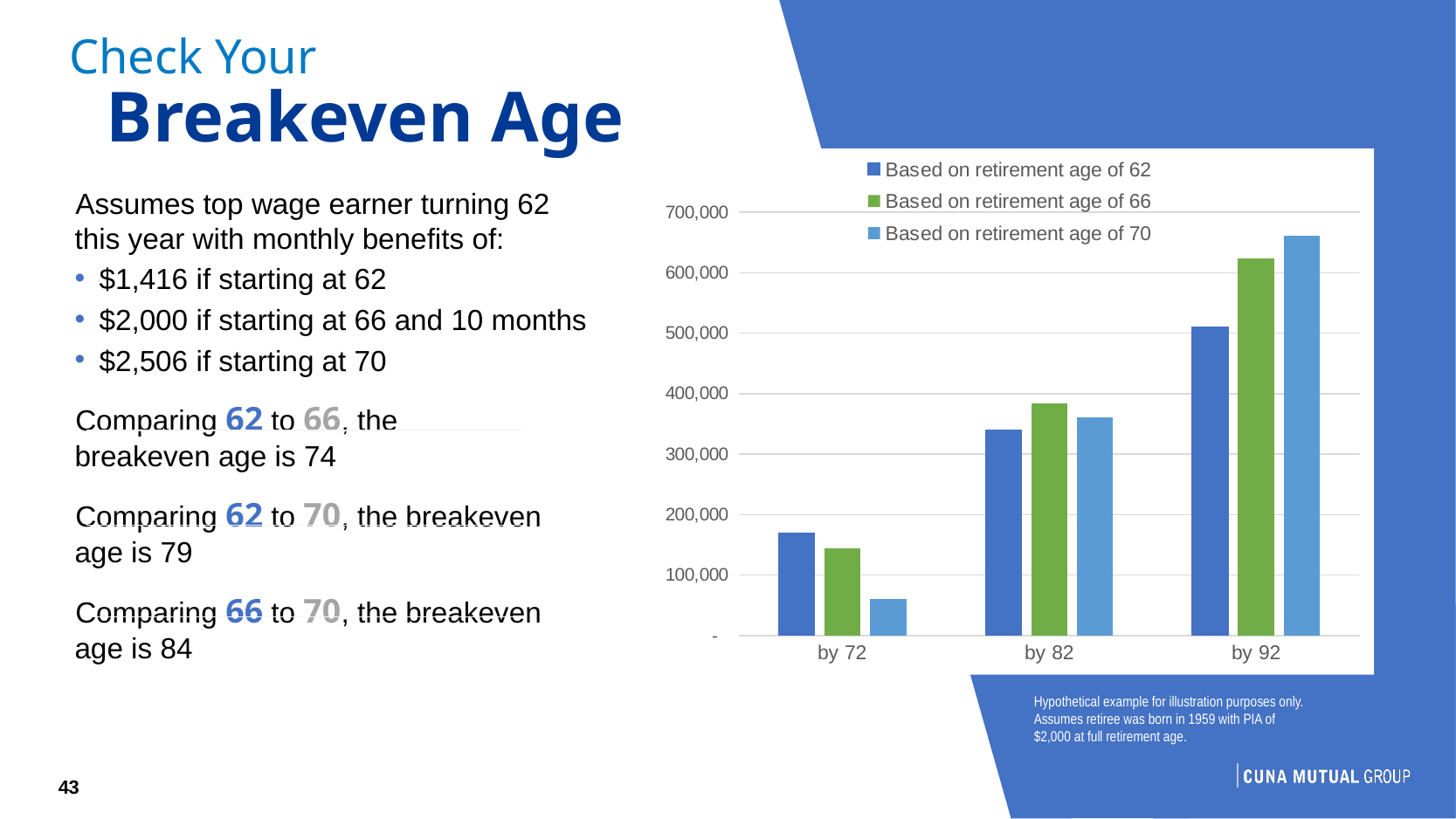
Do the values for 'Based on retirement age of 62' rise or fall from 'by 72' to 'by 92'? rise In the 'by 82' category, which is larger: the bar for retirement age of 66 or the bar for retirement age of 62? Based on retirement age of 66 Is the value for 'Based on retirement age of 62' in the 'by 72' category greater or less than 100,000? greater What is the label of the first category on the x axis of the chart? by 72 Which series has the shortest bar in the 'by 72' category? Based on retirement age of 70 Is the value for 'Based on retirement age of 70' in the 'by 72' category greater or less than 100,000? less How many categories are shown on the x axis of the chart? 3 Is the value for 'Based on retirement age of 70' in the 'by 92' category greater or less than 600,000? greater Which series has the tallest bar in the 'by 92' category? Based on retirement age of 70 How many series does the chart's legend list? 3 What kind of chart is shown on the slide? bar chart Which series has the tallest bar in the 'by 72' category? Based on retirement age of 62